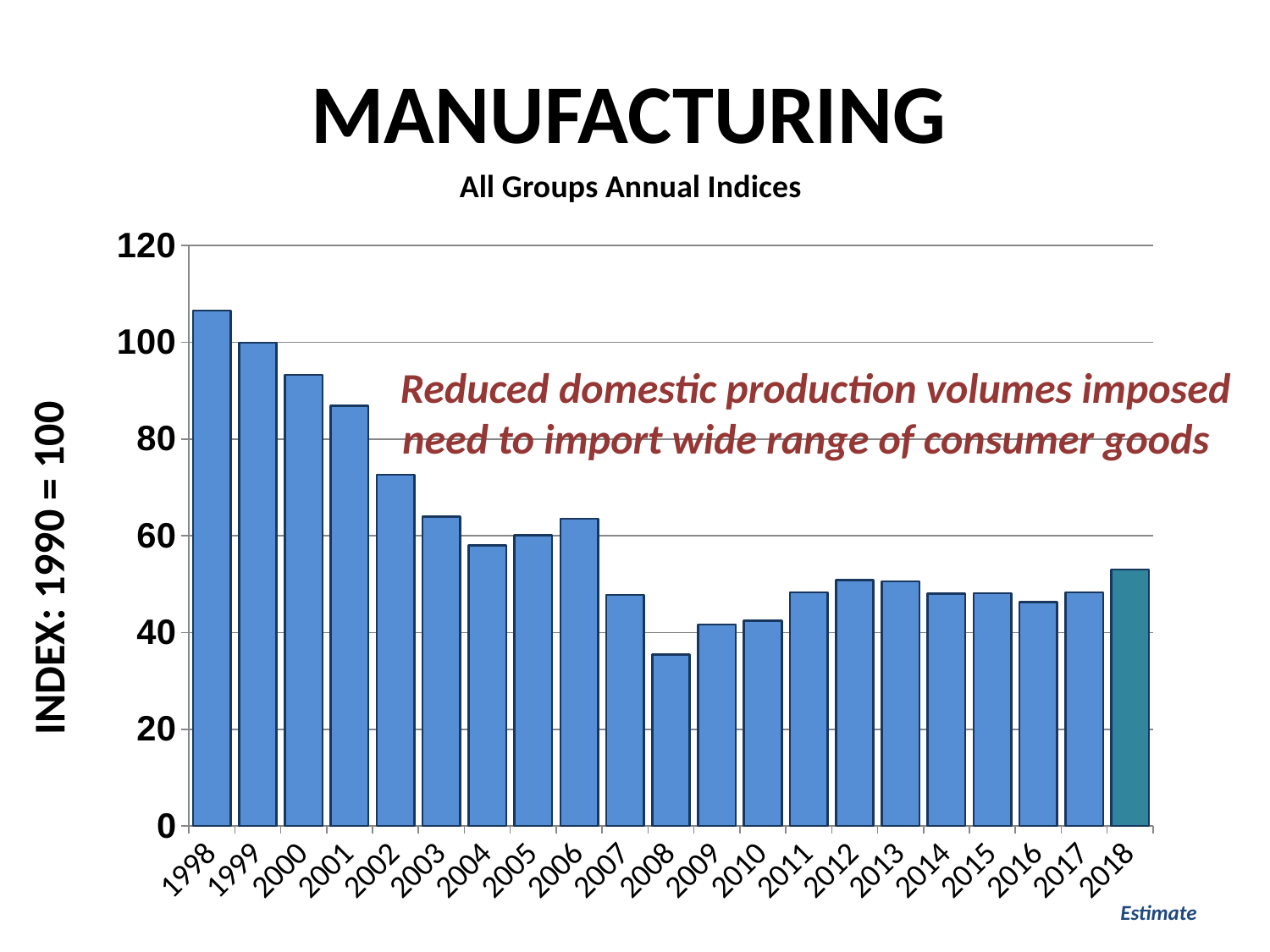
Is the value for 2008 greater or less than 40? less Is the value for 1998 greater or less than 100? greater Which is larger, the value for 1998 or the value for 2018? 1998 What is the label on the vertical axis? INDEX: 1990 = 100 Which is larger, the value for 2008 or the value for 2012? 2012 Is the value for 2002 greater or less than 60? greater Do the values rise or fall from 1998 to 2003? fall How many years are plotted on the chart? 21 What kind of chart is shown on the slide? bar chart Which year has the lowest index value? 2008 Which year has the highest index value? 1998